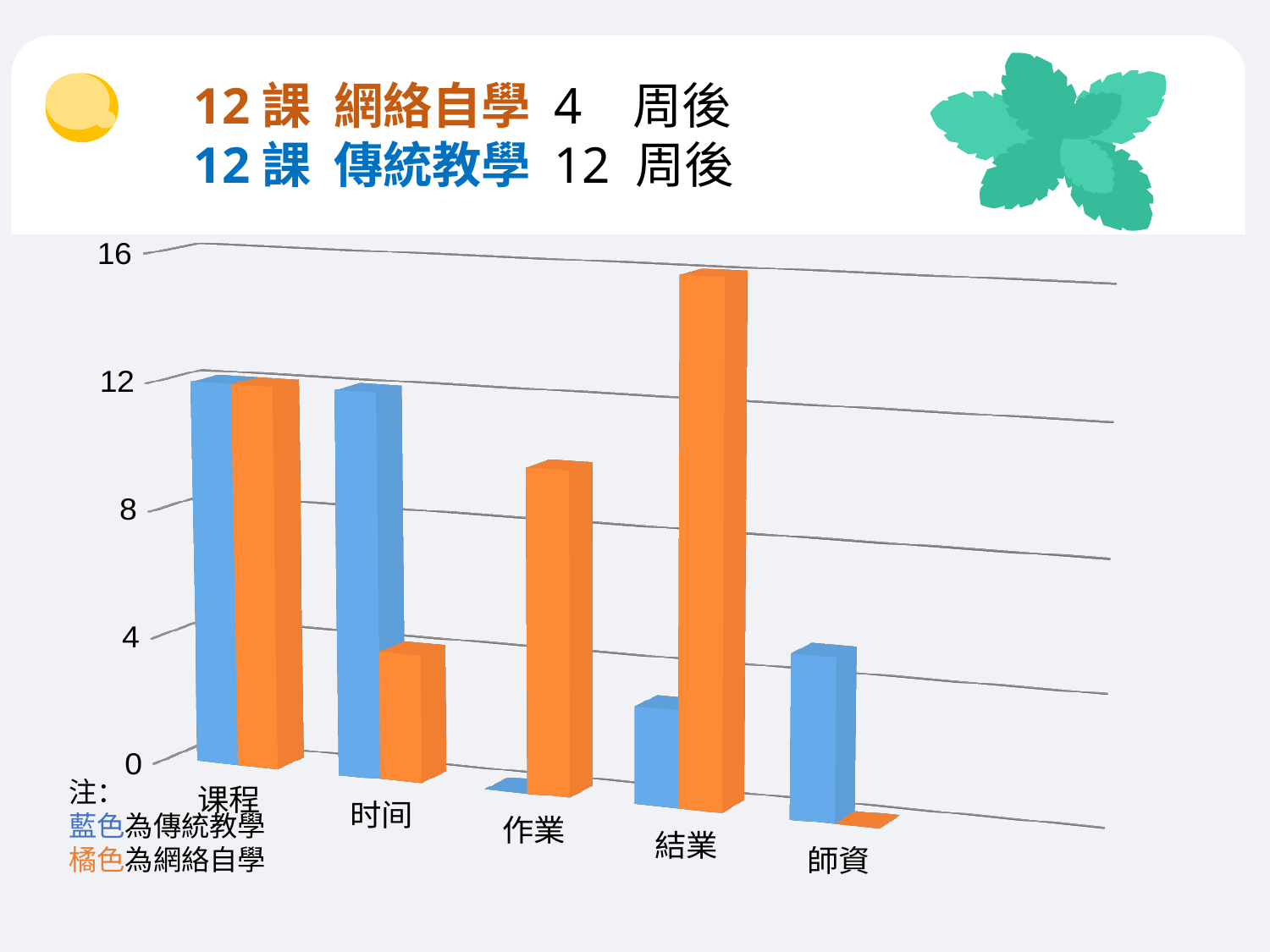
Which category has the highest orange (網絡自學) bar? 結業 Which category has the lowest orange (網絡自學) bar? 師資 Is the orange (網絡自學) value for 結業 greater or less than 12? greater Which category has the lowest blue (傳統教學) bar? 作業 According to the note on the slide, which series do the orange bars represent? 網絡自學 For 时间, which is larger: the blue (傳統教學) bar or the orange (網絡自學) bar? blue (傳統教學) According to the note on the slide, which series do the blue bars represent? 傳統教學 What kind of chart is shown on the slide? bar chart How many categories are shown on the x axis of the chart? 5 How many series does the chart's note (legend) list? 2 For 結業, which is larger: the blue (傳統教學) bar or the orange (網絡自學) bar? orange (網絡自學) Is the orange (網絡自學) value for 时间 greater or less than 8? less